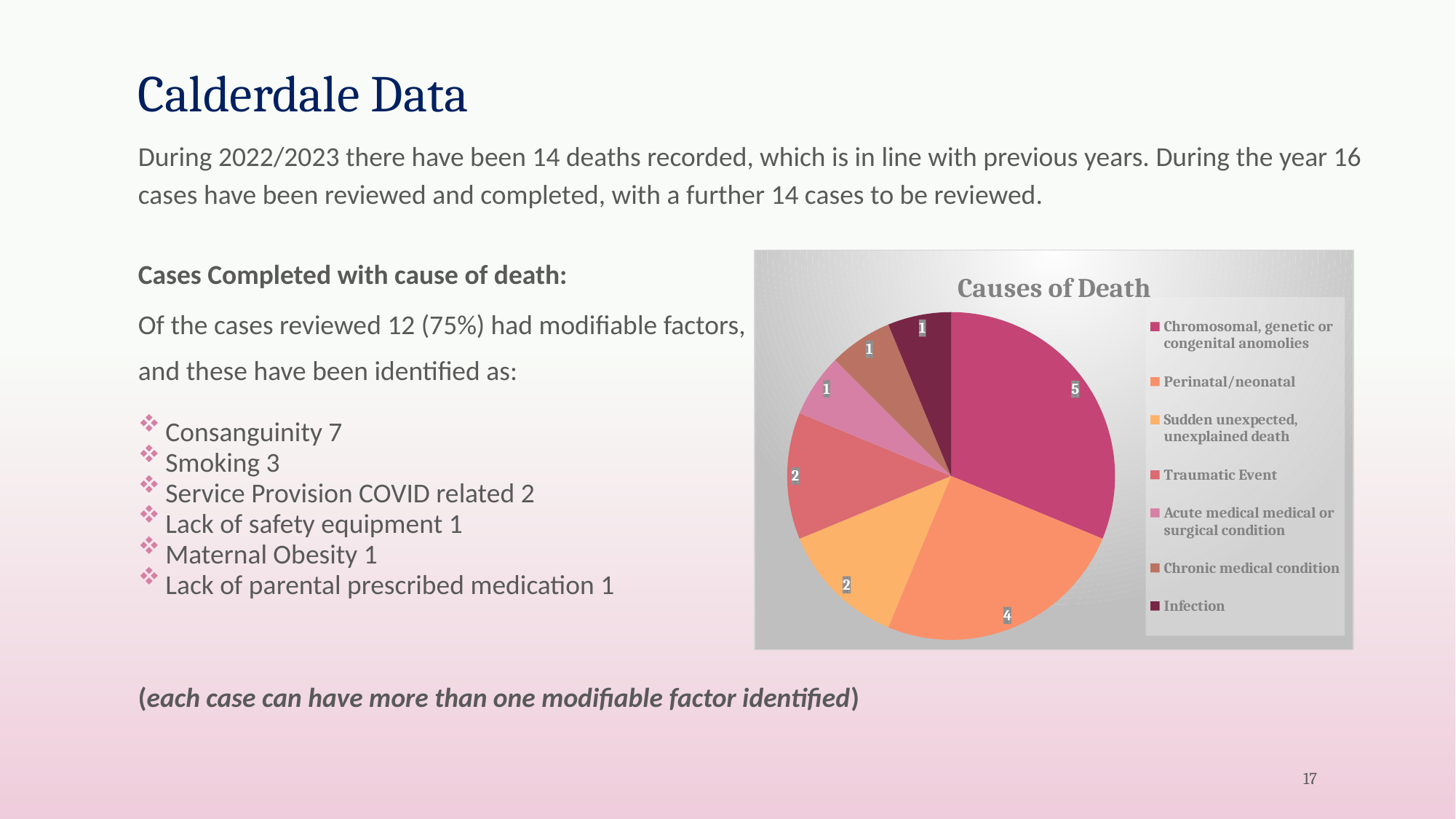
Which is larger, the value for Sudden unexpected, unexplained death or the value for Perinatal/neonatal? Perinatal/neonatal What is the value for Traumatic Event in the pie chart? 2 What is the title of the chart? Causes of Death What is the total of all the slices in the Causes of Death pie chart? 16 What is the value for Perinatal/neonatal in the pie chart? 4 What is the value for Infection in the pie chart? 1 What share of the pie does Perinatal/neonatal represent? 25% How many categories does the Causes of Death pie chart have? 7 What type of chart is shown on the slide? pie chart What is the value for Chromosomal, genetic or congenital anomolies in the pie chart? 5 Which category has the largest slice in the Causes of Death pie chart? Chromosomal, genetic or congenital anomolies What is the difference between the values for Chromosomal, genetic or congenital anomolies and Perinatal/neonatal? 1